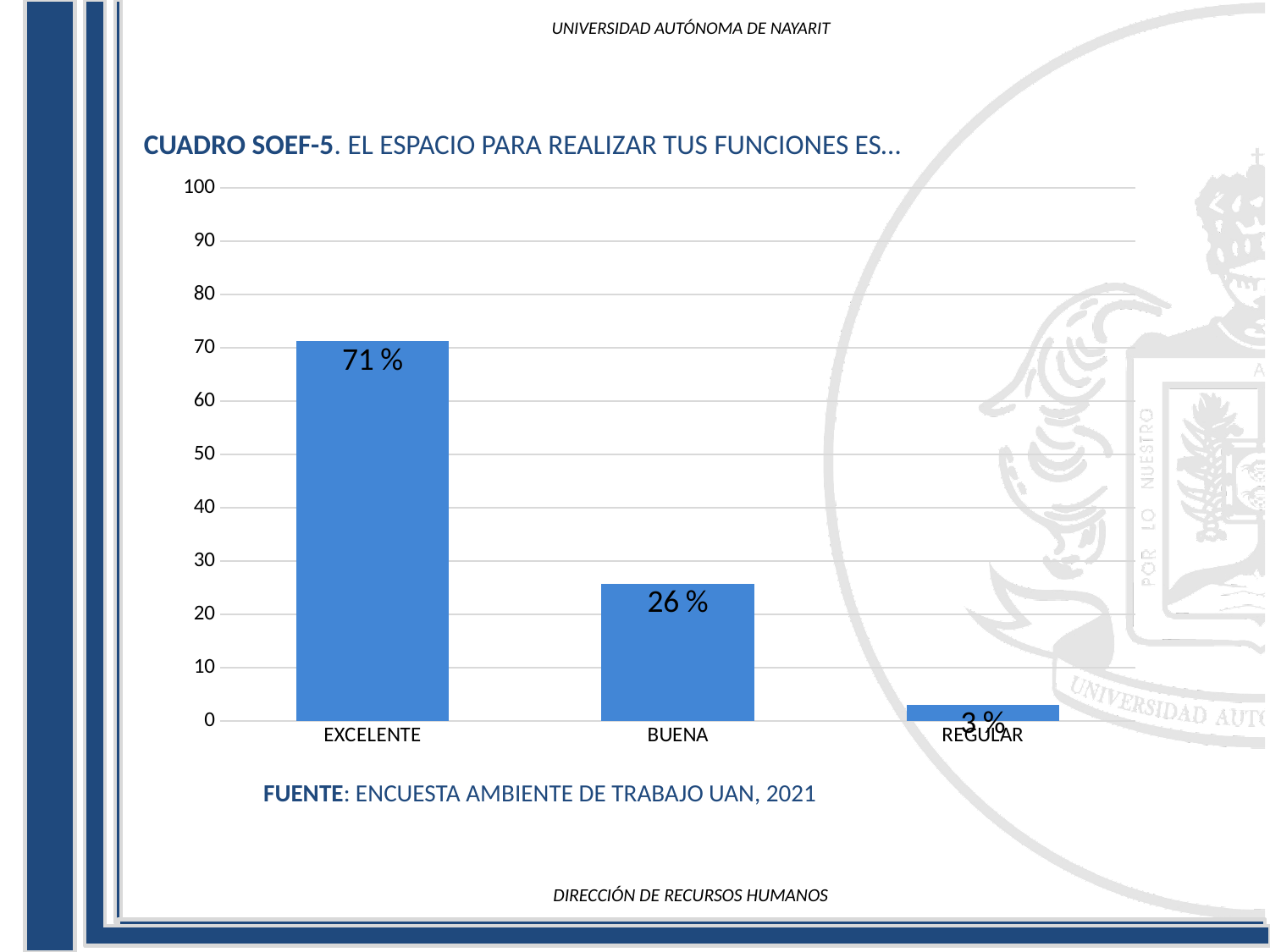
What kind of chart is shown on the slide? bar chart Which category has the lowest value? REGULAR What is the value for REGULAR? 3 % Do the values rise or fall from left to right along the x axis? fall What is the difference between the values for BUENA and REGULAR? 23 % What is the difference between the values for EXCELENTE and BUENA? 45 % How many categories are shown on the x axis? 3 Which is larger, the value for BUENA or the value for REGULAR? BUENA Which category has the highest value? EXCELENTE What is the value for EXCELENTE? 71 % What is the value for BUENA? 26 % Is the value for EXCELENTE greater or less than 60? greater